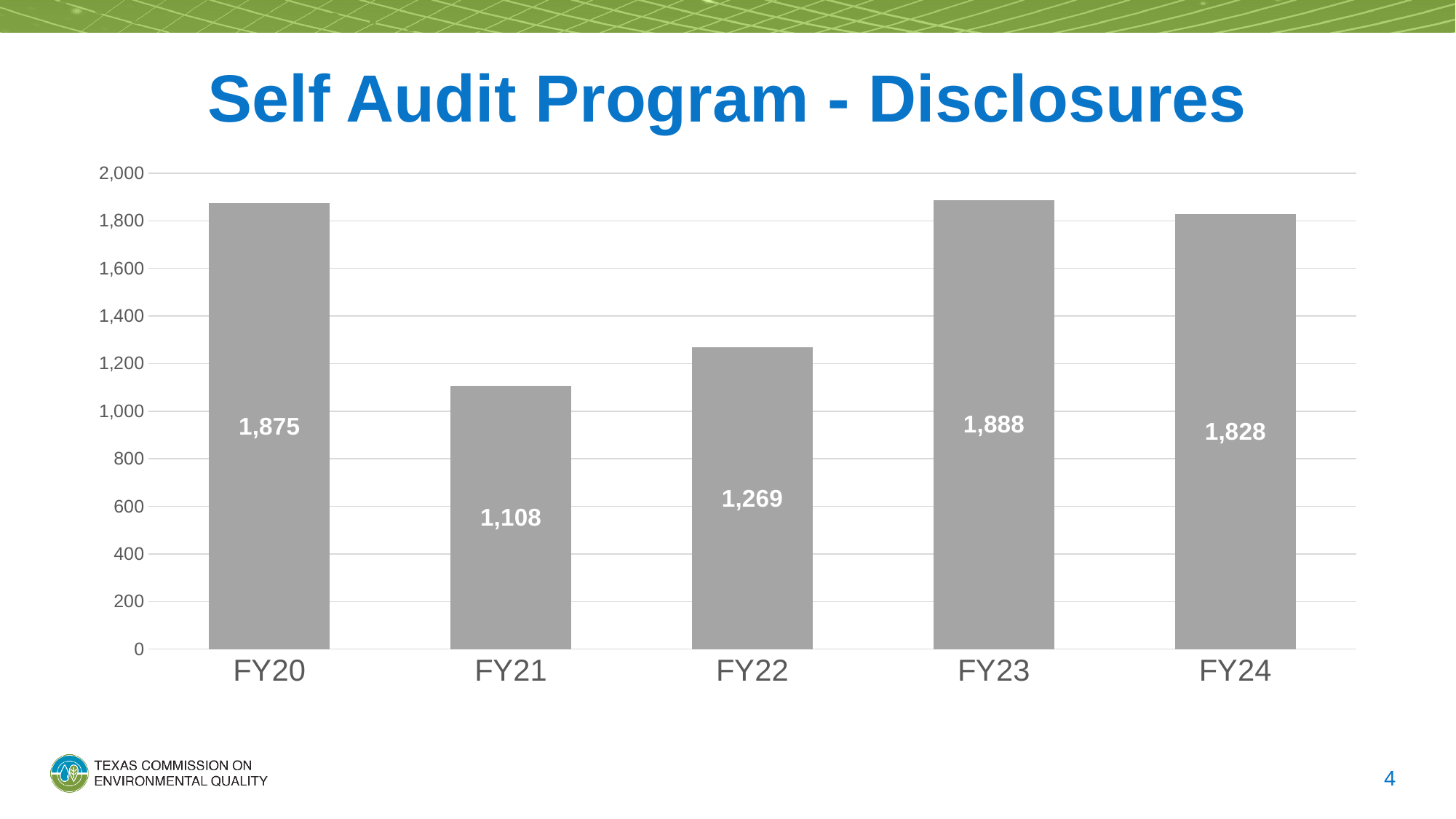
What is the number of disclosures for FY20? 1,875 What is the number of disclosures for FY21? 1,108 What type of chart is shown on the slide? Bar chart What is the difference between the disclosures in FY23 and FY21? 780 What is the number of disclosures for FY22? 1,269 Which has more disclosures, FY22 or FY24? FY24 Which fiscal year has the lowest number of disclosures? FY21 What is the difference between the disclosures in FY20 and FY24? 47 Is the value for FY22 greater or less than 1,400? less How many fiscal years are shown on the chart? 5 What is the number of disclosures for FY24? 1,828 Which fiscal year has the highest number of disclosures? FY23